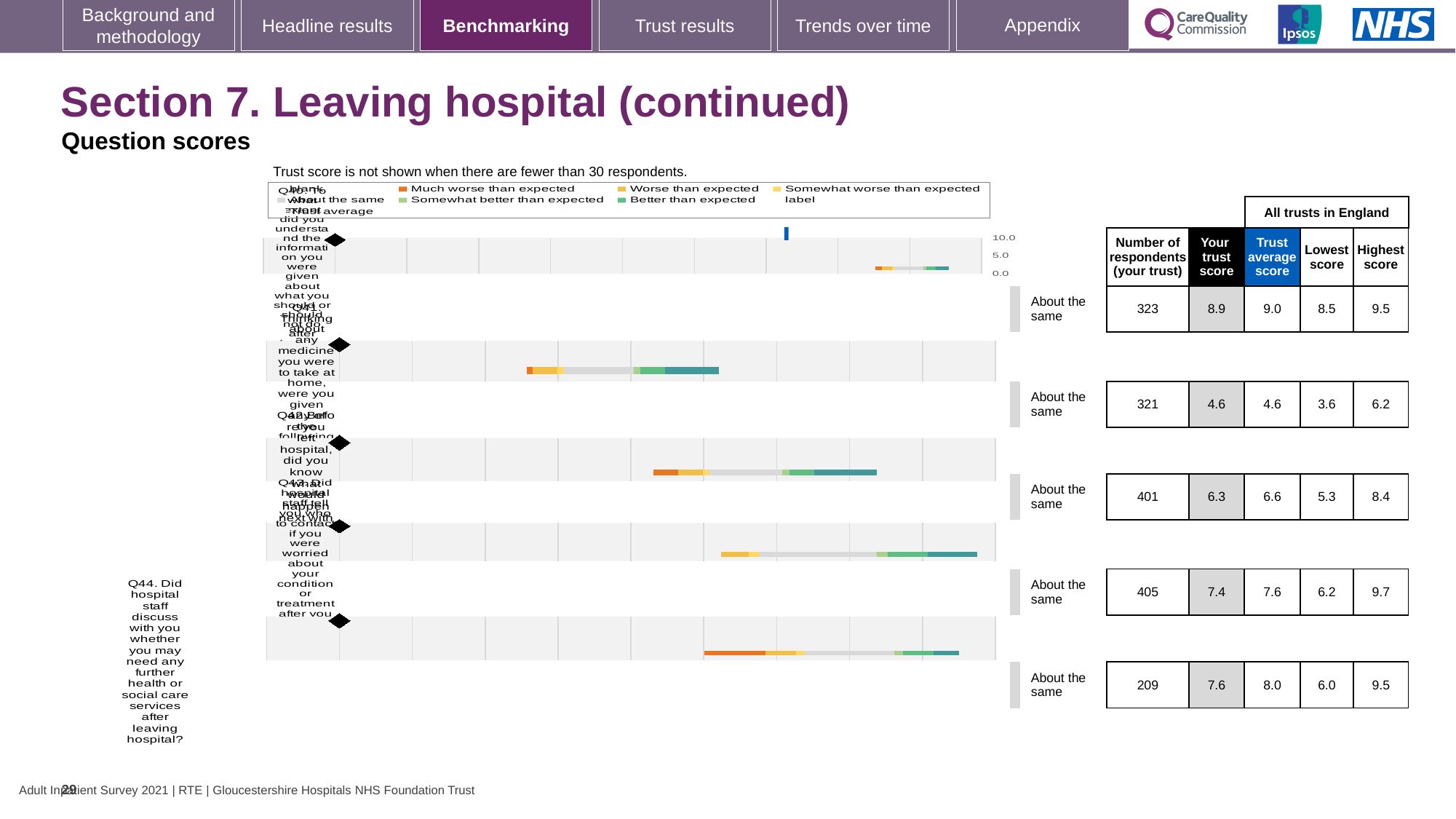
For Q44, which is larger: your trust score or the trust average score? Trust average score What is the lowest score across all trusts in England for Q44? 6.0 What is the highest score across all trusts in England for Q44? 9.5 How many question rows are shown in the benchmarking chart? 5 What is the lowest 'Your trust score' shown in the table? 4.6 What is your trust's score for Q44 (further health or social care services after leaving hospital)? 7.6 What is the largest number of respondents shown in the table? 405 For Q44, what is the difference between the trust average score and your trust score? 0.4 How many respondents from your trust answered Q44 about further health or social care services after leaving hospital? 209 How many respondents are listed for the first question row in the table? 323 What benchmark category is shown for every question row on this slide? About the same What is the trust average score for Q44 (further health or social care services after leaving hospital)? 8.0